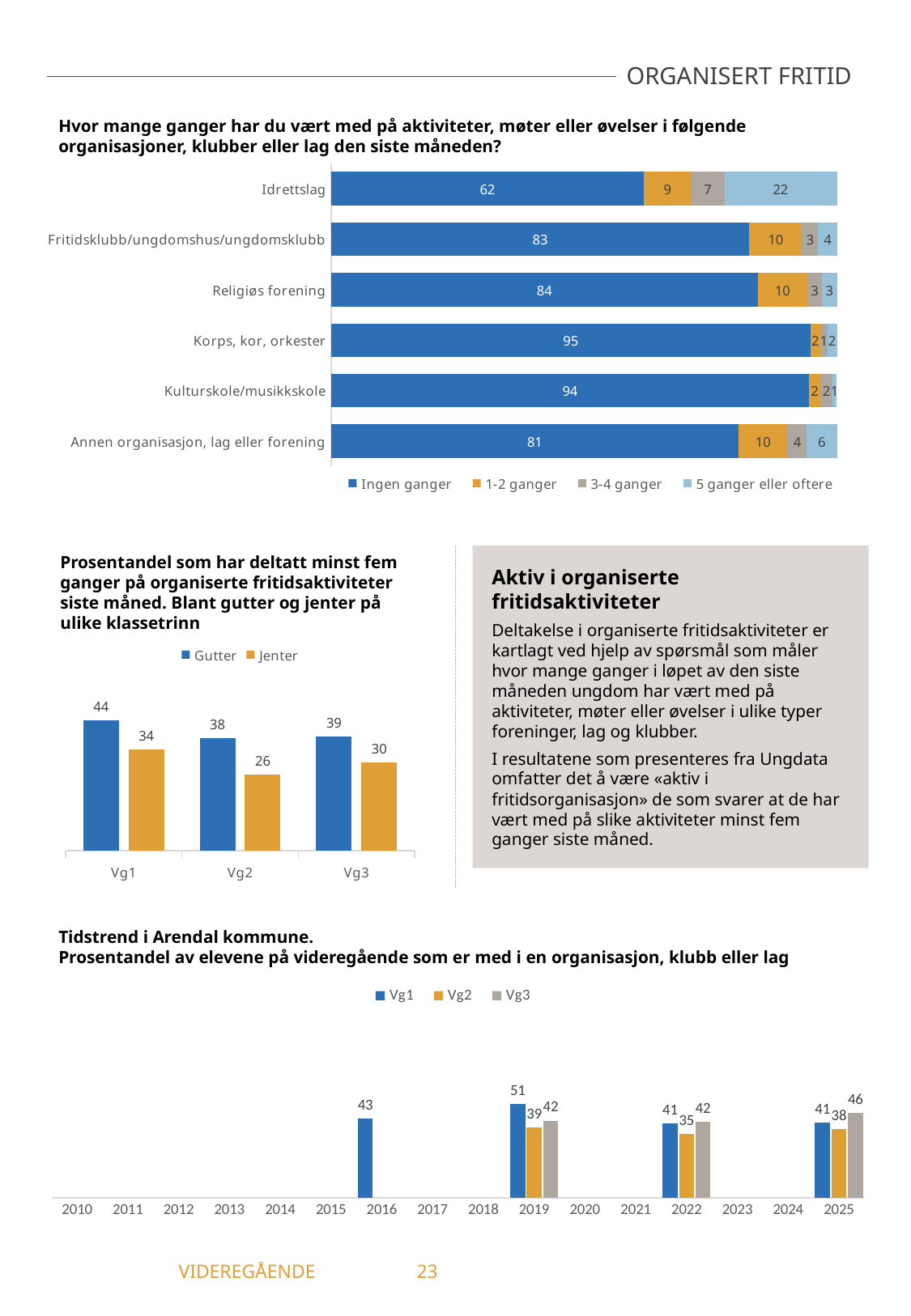
In the middle chart (Prosentandel som har deltatt minst fem ganger...), what is the value for Jenter at Vg2? 26 In the top chart, how many categories are shown? 6 In the middle chart, which is larger at Vg3, Gutter or Jenter? Gutter In the top chart, what kind of chart is it? Stacked bar chart In the top chart, which category has the highest value for 'Ingen ganger'? Korps, kor, orkester In the bottom chart (Tidstrend i Arendal kommune), what is the value for Vg1 in 2019? 51 In the top chart, how many series does the legend list? 4 In the middle chart, what is the difference between Gutter and Jenter at Vg1? 10 In the bottom chart, what is the value for Vg3 in 2025? 46 In the top chart (Hvor mange ganger har du vært med på aktiviteter...), what is the value for 'Ingen ganger' for Idrettslag? 62 In the bottom chart, what is the difference between Vg1 and Vg2 in 2022? 6 In the top chart, what is the value for '5 ganger eller oftere' for Idrettslag? 22